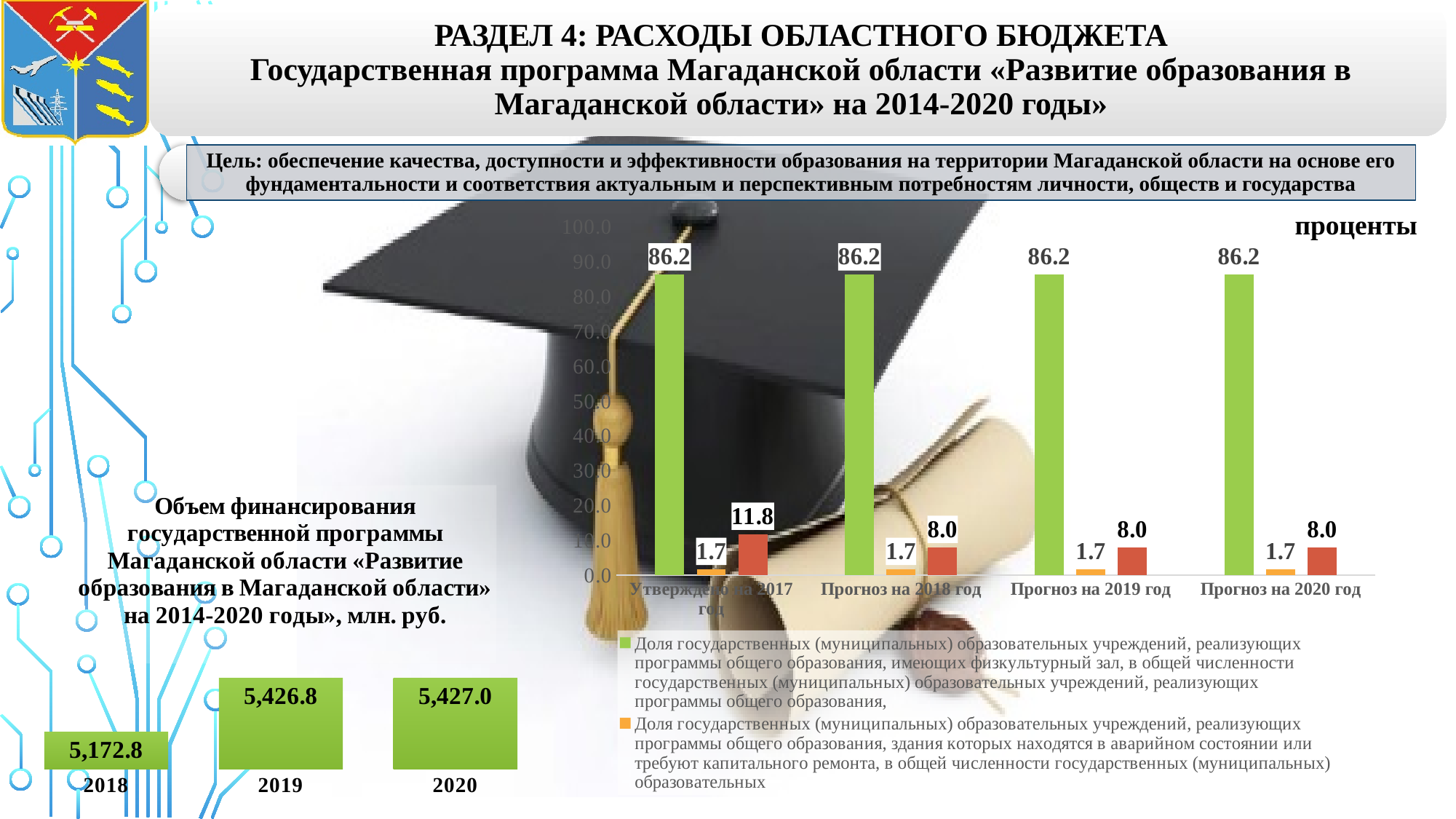
In the right chart (проценты), how many categories are shown on the x axis? 4 In the right chart (проценты), what is the value of the orange series for Прогноз на 2019 год? 1.7 In the right chart (проценты), in which category is the red series highest? Утверждено на 2017 год In the left chart on funding volume, what is the value for 2018? 5,172.8 In the left chart on funding volume, which year has the lowest value? 2018 In the right chart (проценты), what is the value of the red series for Утверждено на 2017 год? 11.8 In the right chart (проценты), what is the difference between the red series values for Утверждено на 2017 год and Прогноз на 2018 год? 3.8 What type of chart is the left chart on funding volume? bar chart In the right chart (проценты), what is the value of the green series for Прогноз на 2020 год? 86.2 In the left chart on funding volume (Объем финансирования), what is the value for 2019? 5,426.8 In the left chart on funding volume, how many years are shown? 3 In the left chart on funding volume, what is the difference between the 2019 and 2018 values? 254.0